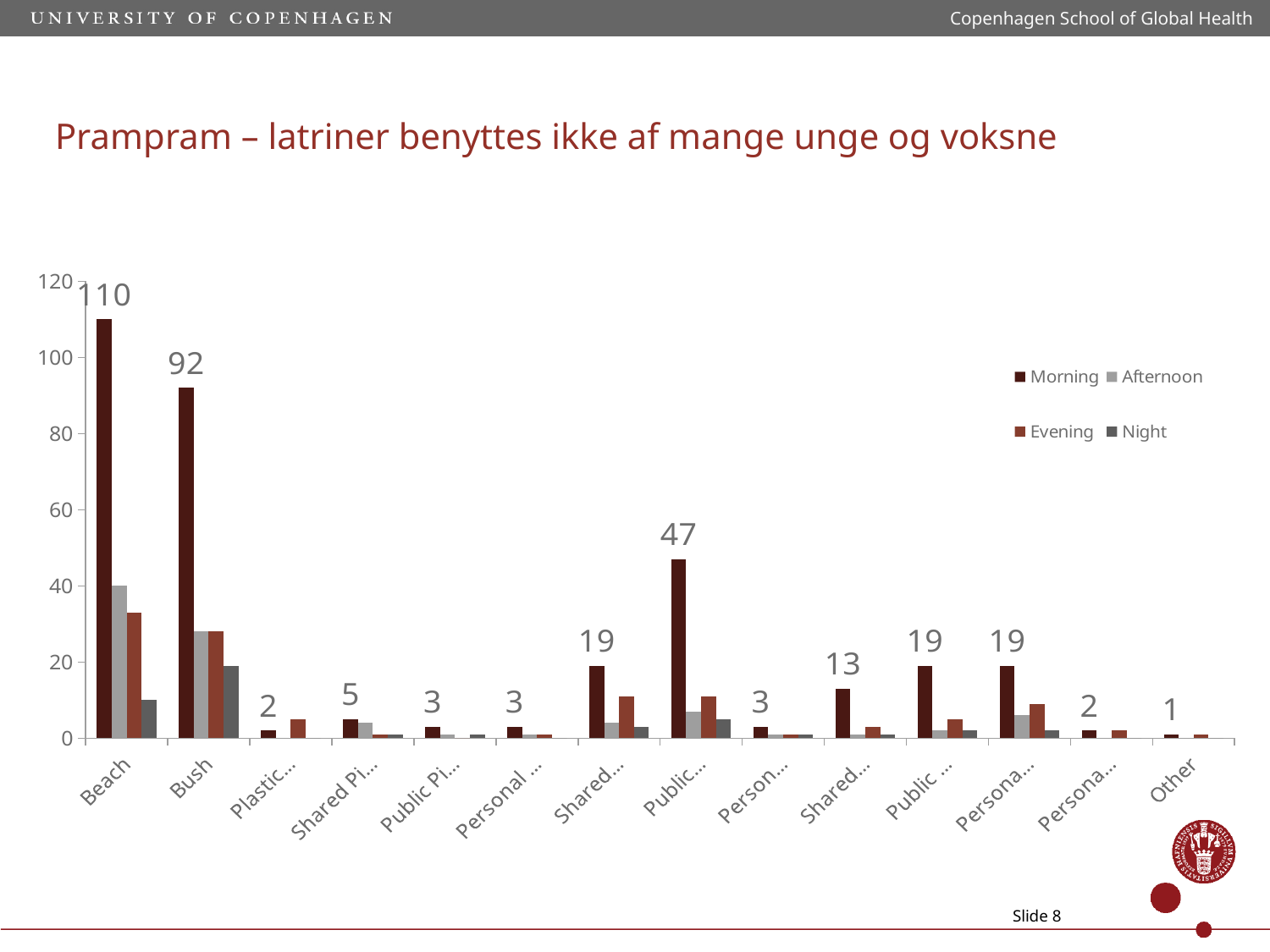
Is the Night value for Beach greater or less than 20? less How many series does the legend list? 4 What is the Morning value for Bush? 92 How many categories are shown on the x axis? 14 What is the Morning value for Other? 1 What is the Morning value for Beach? 110 Is the Afternoon value for Beach greater or less than 20? greater Which category has the highest Morning value? Beach What kind of chart is shown on the slide? bar chart What is the difference between the Morning values for Beach and Bush? 18 Which category has the lowest Morning value? Other Which has the larger Morning value, Beach or Bush? Beach